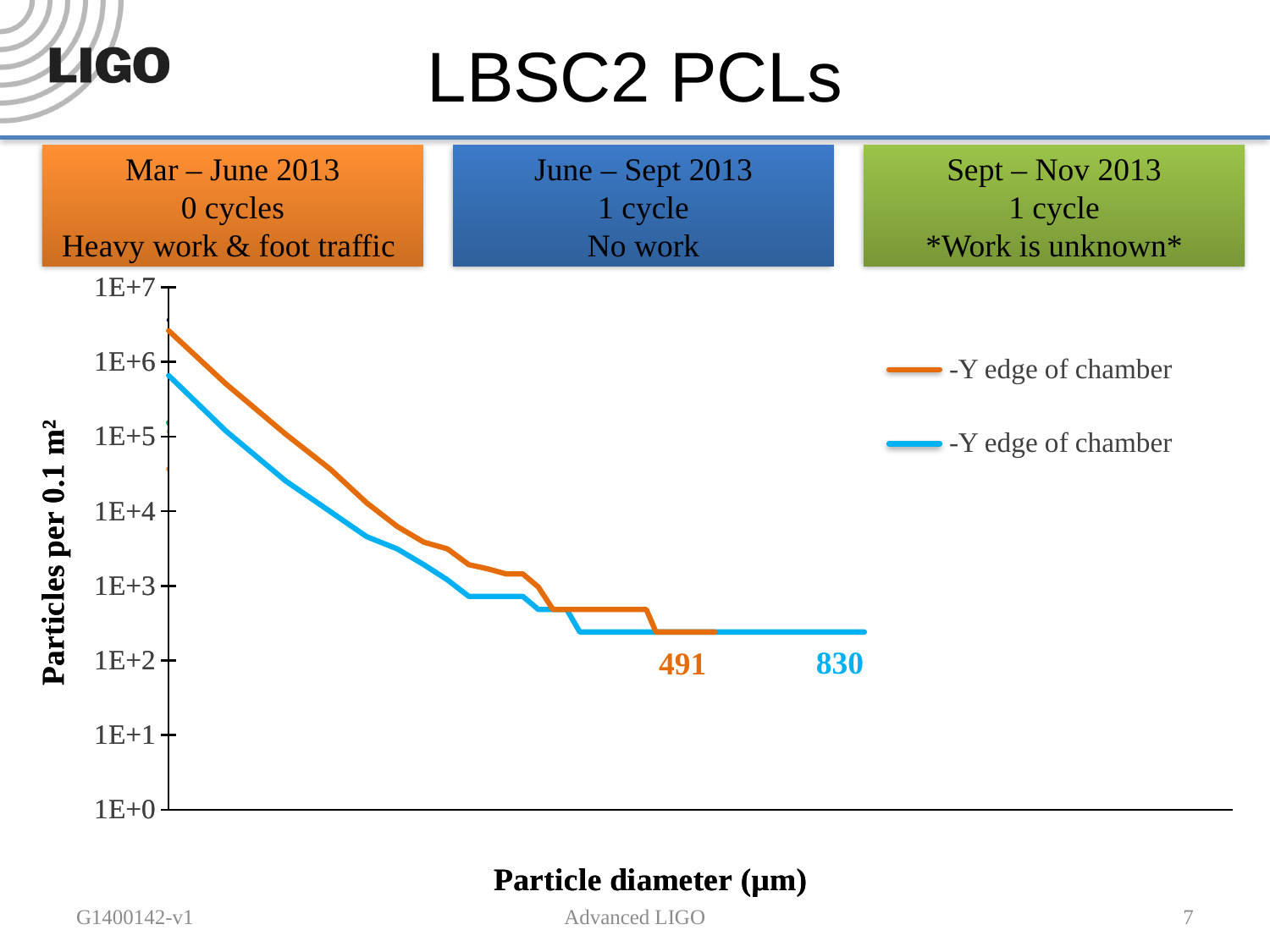
At the right end of the blue line, is its value greater or less than 1E+3? less What kind of chart is shown on the slide? line chart What label does the legend give to the orange series? -Y edge of chamber How many series does the legend list? 2 At the left end of the chart, is the value of the blue line greater or less than 1E+6? less At the left end of the chart, is the value of the orange line greater or less than 1E+6? greater Do the plotted values rise or fall as particle diameter increases along the x axis? fall What number is printed in blue near the end of the blue line? 830 At the left end of the chart, which line has the higher value, the orange line or the blue line? orange line